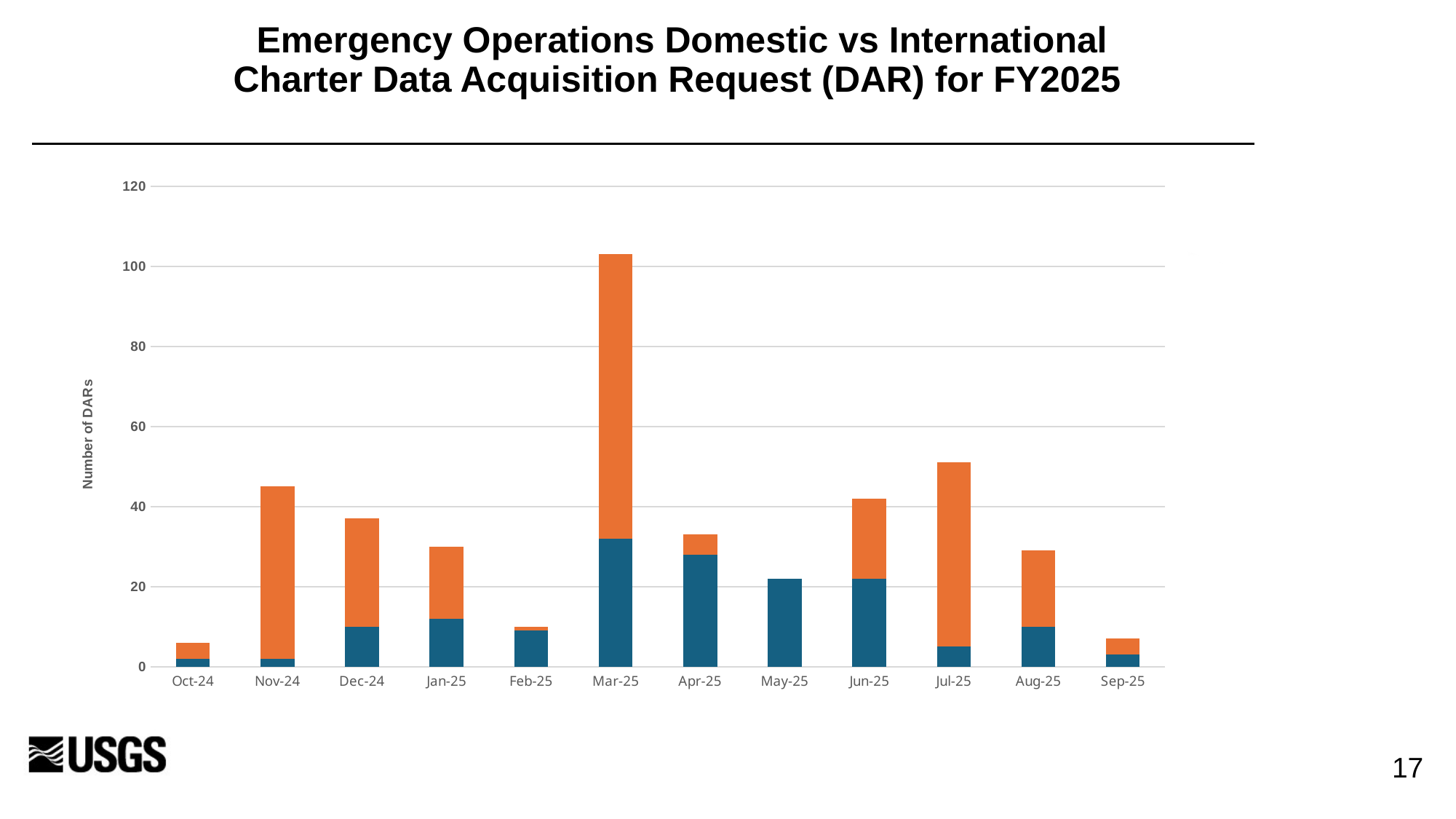
How many months are shown on the x axis of the chart? 12 Which month has the highest total number of DARs? Mar-25 Which has the larger total number of DARs, Jul-25 or Jun-25? Jul-25 Is the total value for Aug-25 greater or less than 40? less Is the total value for Jul-25 greater or less than 40? greater Is the total value for Feb-25 greater or less than 20? less What is the label on the vertical axis of the chart? Number of DARs Which month's bar consists only of the blue segment, with no orange segment? May-25 What kind of chart is shown on the slide? Stacked bar chart Which has the larger total number of DARs, Apr-25 or May-25? Apr-25